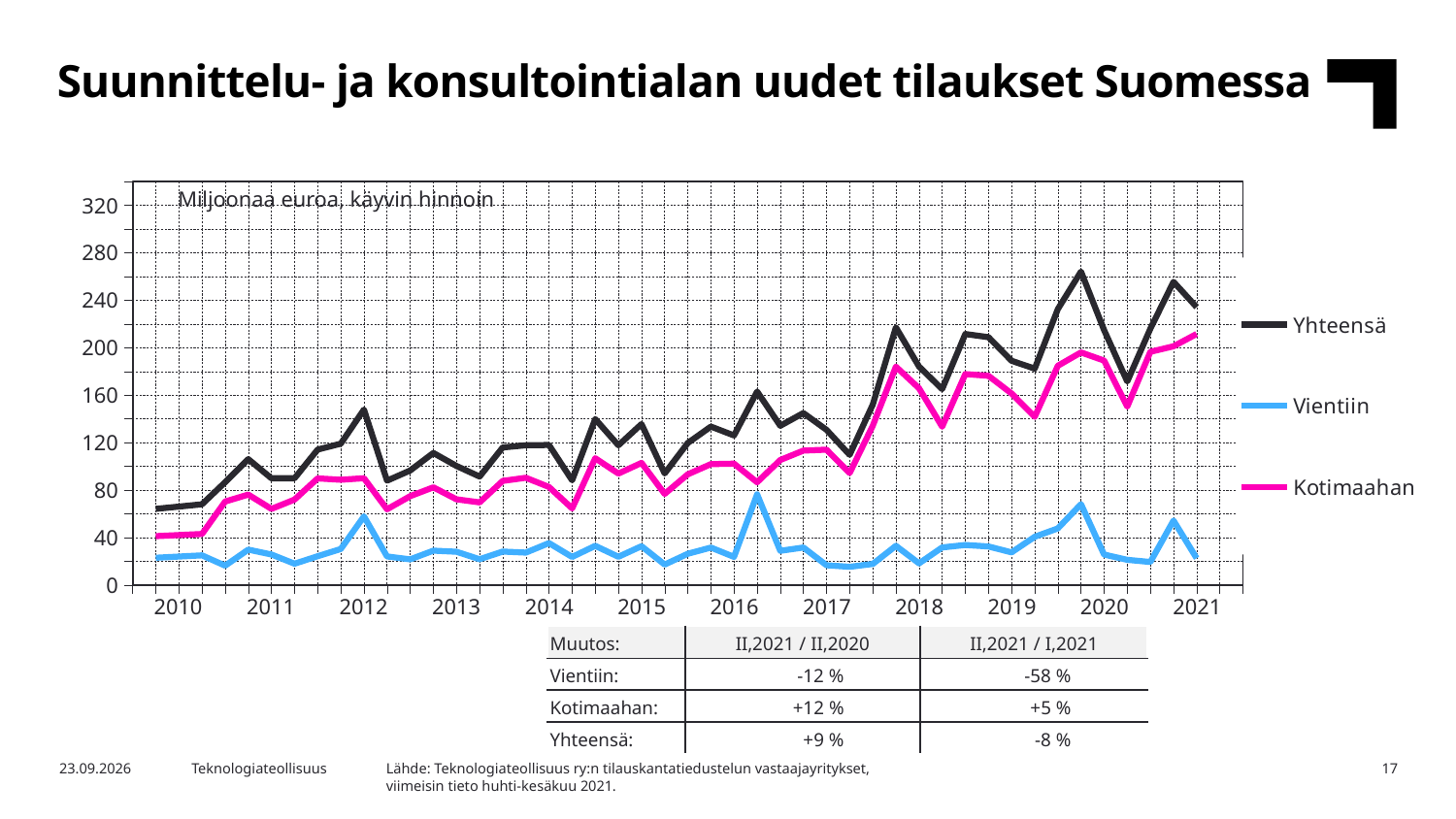
Is the peak value of the Yhteensä line greater or less than 240? greater What unit is stated in the chart's subtitle? Miljoonaa euroa, käyvin hinnoin At the end of the series in 2021, which is larger: Kotimaahan or Vientiin? Kotimaahan How many series does the legend list? 3 What are the series names listed in the legend? Yhteensä, Vientiin, Kotimaahan Which series has the lowest values throughout the chart? Vientiin Is the value of the Yhteensä line at the start of 2010 greater or less than 80? less Is the value of the Vientiin line at the start of 2010 greater or less than 40? less What kind of chart is shown on the slide? line chart Which series has the highest values throughout the chart? Yhteensä Does the Yhteensä line overall rise or fall from 2010 to 2021? rise